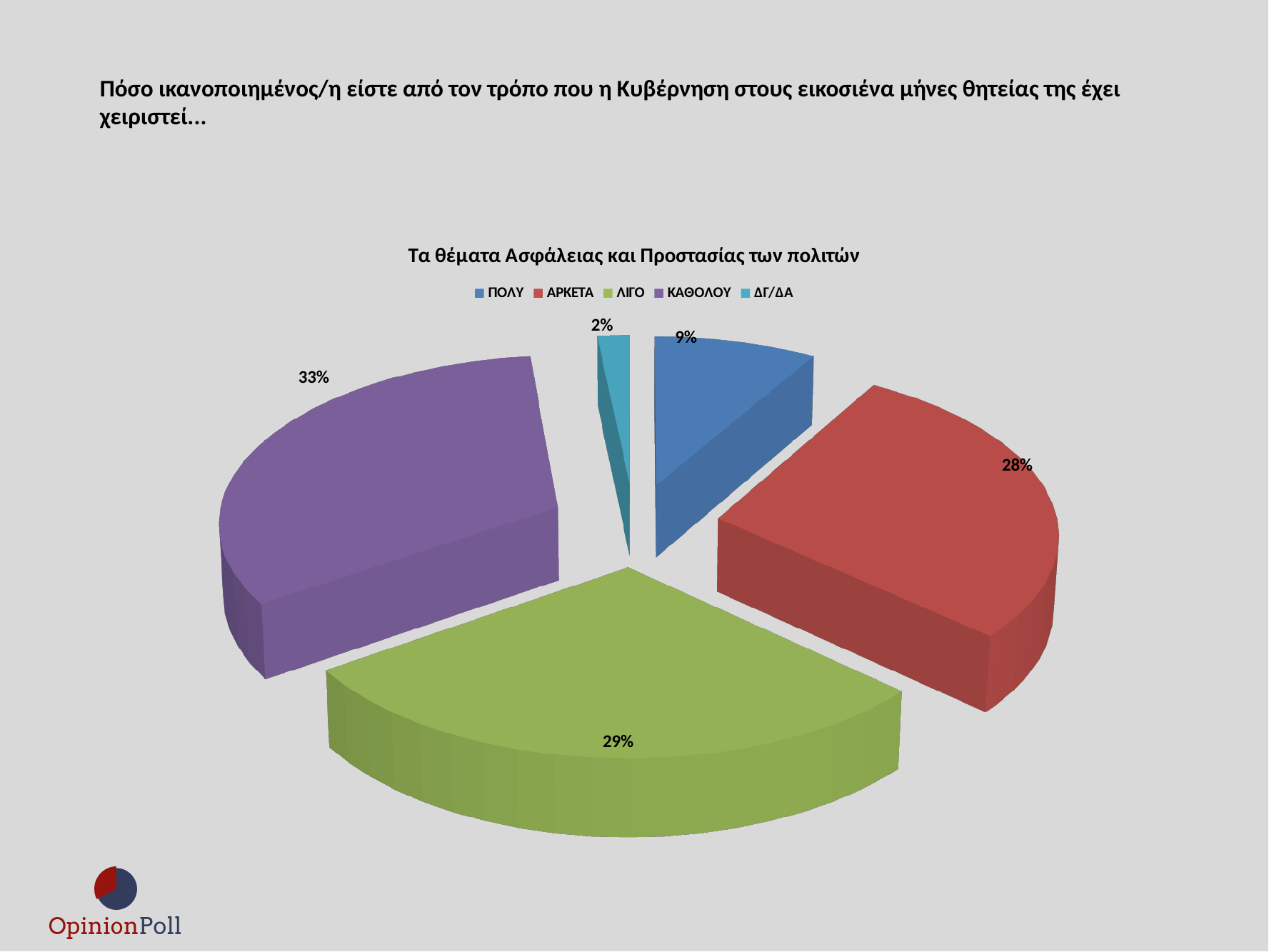
Which category has the largest share of the pie? ΚΑΘΟΛΟΥ What percentage of the pie is ΑΡΚΕΤΑ? 28% How many categories does the legend list? 5 What percentage of the pie is ΛΙΓΟ? 29% What percentage of the pie is ΠΟΛΥ? 9% What kind of chart is shown on the slide? pie chart What is the title of the pie chart? Τα θέματα Ασφάλειας και Προστασίας των πολιτών Which category has the smallest share of the pie? ΔΓ/ΔΑ What percentage of the pie is ΚΑΘΟΛΟΥ? 33% What percentage of the pie is ΔΓ/ΔΑ? 2% What is the difference in percentage points between ΚΑΘΟΛΟΥ and ΠΟΛΥ? 24 Which colour represents ΛΙΓΟ in the pie chart? green